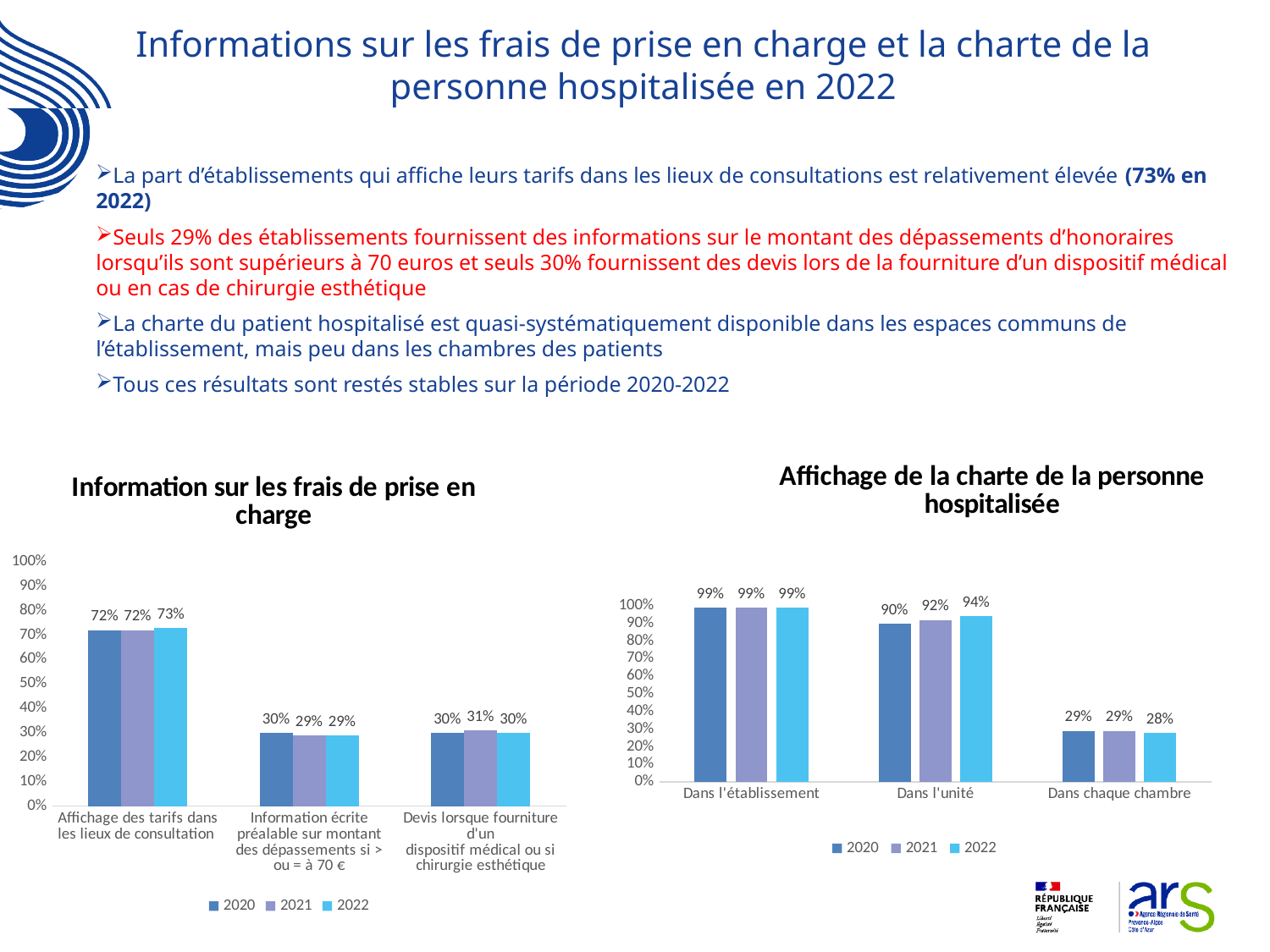
In the chart 'Affichage de la charte de la personne hospitalisée', what is the difference between the 2022 values for 'Dans l'établissement' and 'Dans l'unité'? 5% In the chart 'Affichage de la charte de la personne hospitalisée', which category has the lowest values? Dans chaque chambre In the chart 'Affichage de la charte de la personne hospitalisée', what is the 2022 value for 'Dans l'unité'? 94% What kind of chart is 'Affichage de la charte de la personne hospitalisée'? bar chart In the chart 'Information sur les frais de prise en charge', what is the 2021 value for 'Devis lorsque fourniture d'un dispositif médical ou si chirurgie esthétique'? 31% In the chart 'Information sur les frais de prise en charge', what is the 2022 value for 'Affichage des tarifs dans les lieux de consultation'? 73% In the chart 'Information sur les frais de prise en charge', which category has the highest values? Affichage des tarifs dans les lieux de consultation How many categories are shown on the x axis of the chart 'Affichage de la charte de la personne hospitalisée'? 3 In the chart 'Affichage de la charte de la personne hospitalisée', what is the 2020 value for 'Dans chaque chambre'? 29% In the chart 'Information sur les frais de prise en charge', what is the difference between the 2020 values for 'Affichage des tarifs dans les lieux de consultation' and 'Information écrite préalable sur montant des dépassements si > ou = à 70 €'? 42% How many series does the legend of the chart 'Information sur les frais de prise en charge' list? 3 In the chart 'Affichage de la charte de la personne hospitalisée', is the 2021 value for 'Dans l'unité' larger or smaller than the 2021 value for 'Dans chaque chambre'? larger